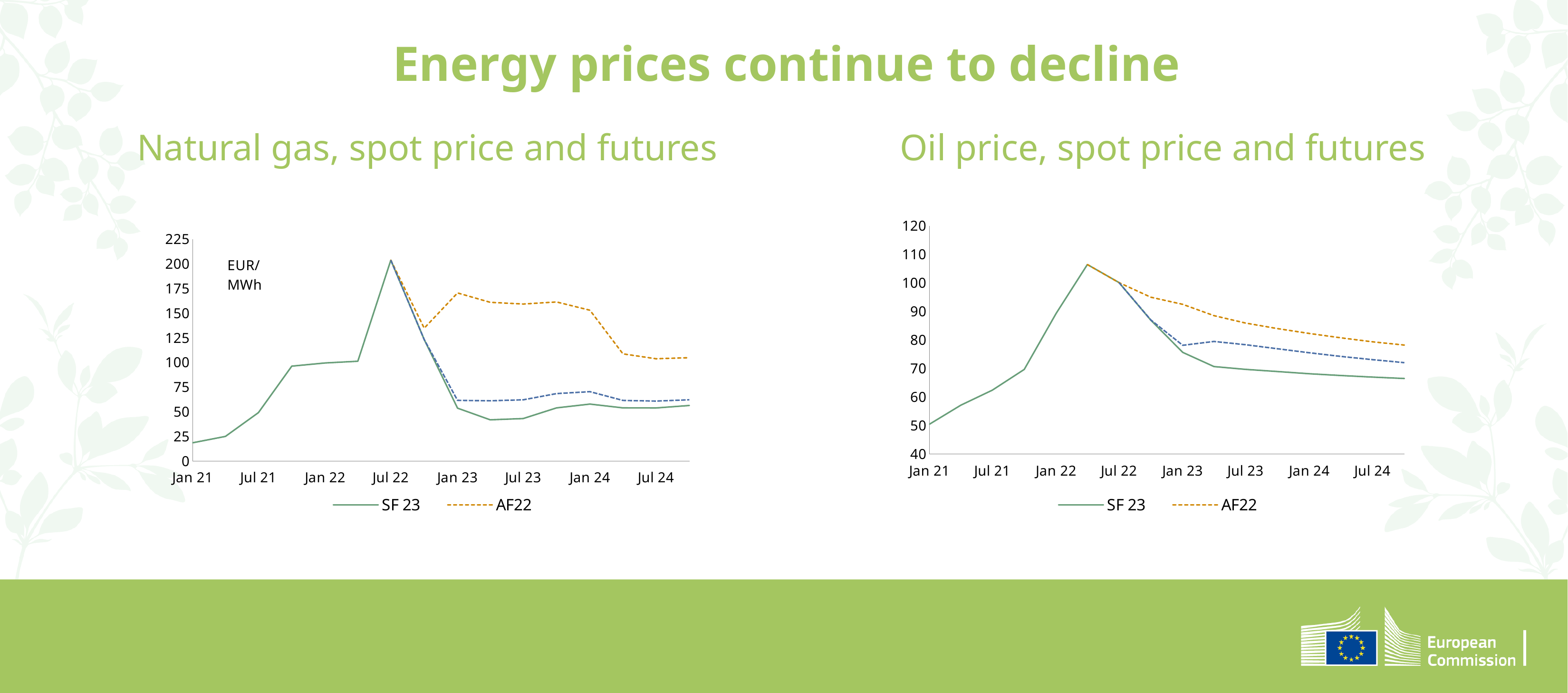
In the 'Oil price, spot price and futures' chart, is the AF22 value at Jul 24 greater or less than 70? greater How many series does the legend of the 'Oil price, spot price and futures' chart list? 2 In the 'Natural gas, spot price and futures' chart, does the SF 23 line rise or fall between Jan 21 and Jul 22? rise In the 'Natural gas, spot price and futures' chart, what unit is shown on the y axis? EUR/MWh What kind of chart is the 'Natural gas, spot price and futures' chart? line chart In the 'Natural gas, spot price and futures' chart, is the AF22 value at Jan 24 greater or less than 125? greater In the 'Oil price, spot price and futures' chart, is the peak value greater or less than 100? greater In the 'Oil price, spot price and futures' chart, does the SF 23 line rise or fall between Jan 23 and Jul 24? fall In the 'Natural gas, spot price and futures' chart, which series is higher at Jul 24, SF 23 or AF22? AF22